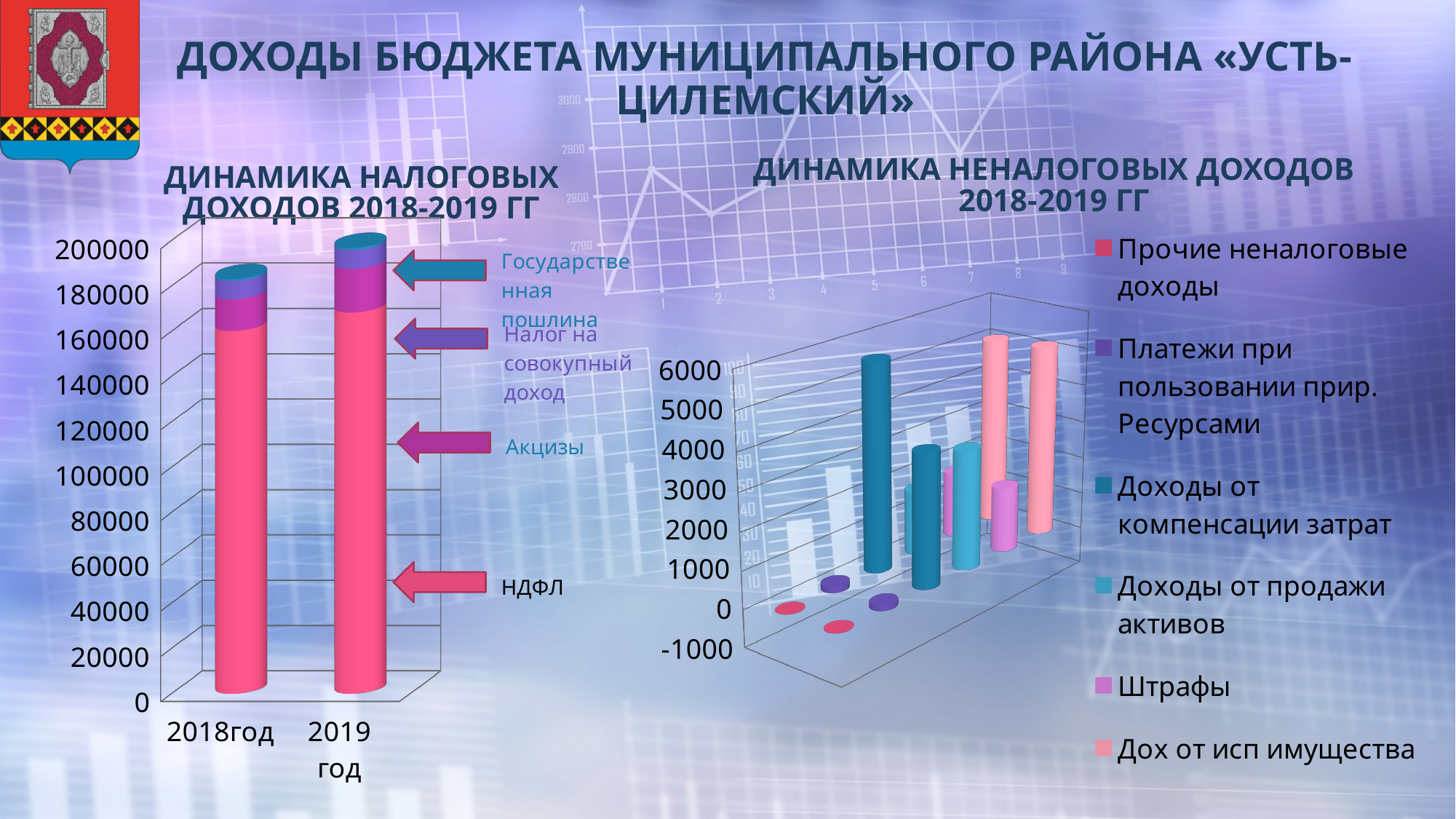
What kind of chart is the right chart, 'ДИНАМИКА НЕНАЛОГОВЫХ ДОХОДОВ 2018-2019 ГГ'? 3D bar chart How many categories (years) are shown on the x axis of the left chart, 'ДИНАМИКА НАЛОГОВЫХ ДОХОДОВ 2018-2019 ГГ'? 2 In the left chart, 'ДИНАМИКА НАЛОГОВЫХ ДОХОДОВ 2018-2019 ГГ', is the total for 2019 год greater or less than 180000? greater In the left chart, 'ДИНАМИКА НАЛОГОВЫХ ДОХОДОВ 2018-2019 ГГ', which year has the taller total bar, 2018 год or 2019 год? 2019 год How many series are labelled on the left chart, 'ДИНАМИКА НАЛОГОВЫХ ДОХОДОВ 2018-2019 ГГ'? 4 How many series does the legend of the right chart, 'ДИНАМИКА НЕНАЛОГОВЫХ ДОХОДОВ 2018-2019 ГГ', list? 6 In the left chart, 'ДИНАМИКА НАЛОГОВЫХ ДОХОДОВ 2018-2019 ГГ', is the total for 2018 год greater or less than 160000? greater What kind of chart is the left chart, 'ДИНАМИКА НАЛОГОВЫХ ДОХОДОВ 2018-2019 ГГ'? Stacked bar chart In the right chart, 'ДИНАМИКА НЕНАЛОГОВЫХ ДОХОДОВ 2018-2019 ГГ', which legend entry is shown in light pink? Дох от исп имущества In the left chart, 'ДИНАМИКА НАЛОГОВЫХ ДОХОДОВ 2018-2019 ГГ', do the total tax revenues rise or fall from 2018 to 2019? rise In the left chart, 'ДИНАМИКА НАЛОГОВЫХ ДОХОДОВ 2018-2019 ГГ', which series makes up the largest part of each bar? НДФЛ